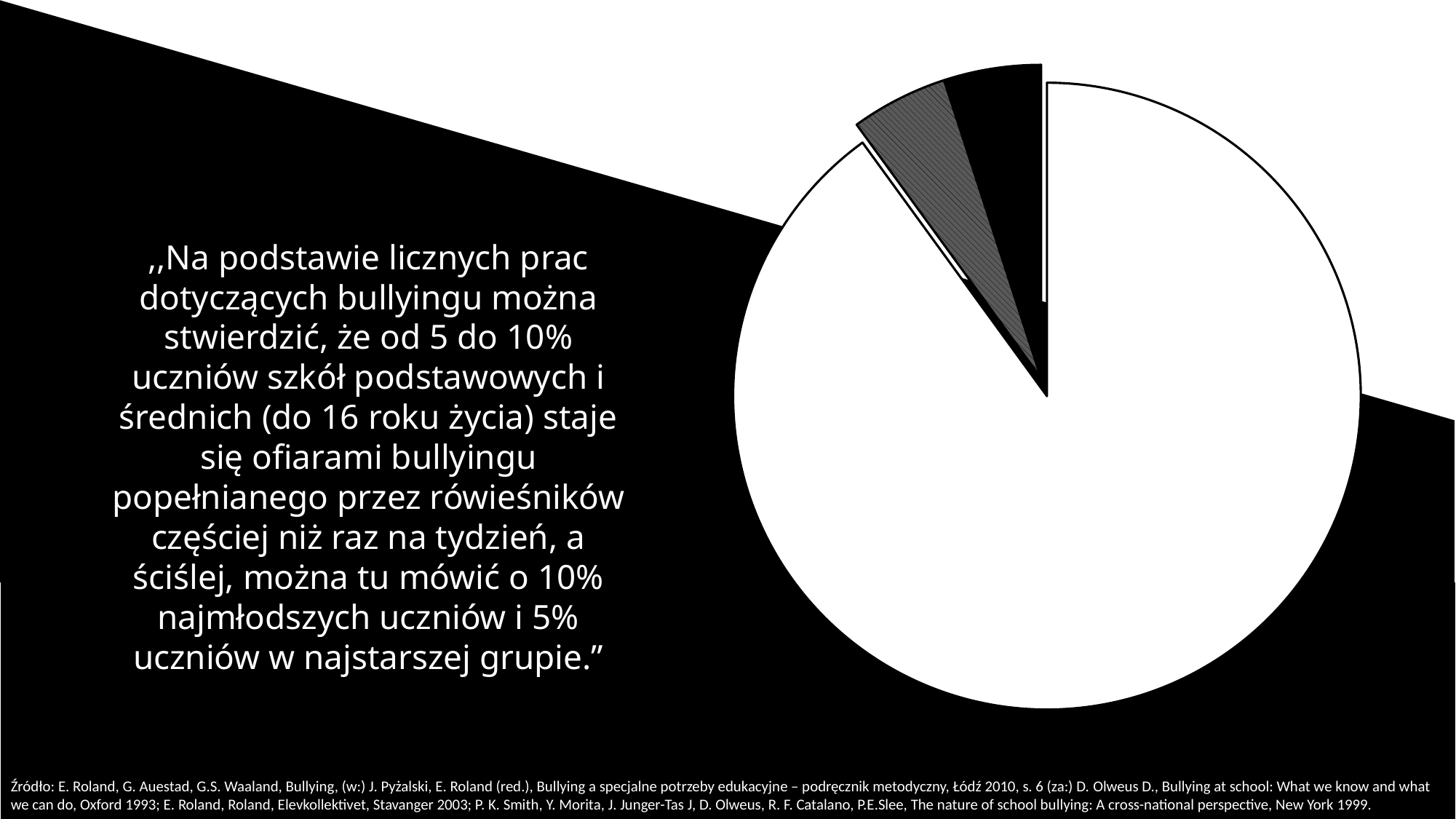
Does the pie chart display a legend? No Does the pie chart show any data labels with values? No How many slices does the pie chart have? 3 Which is larger in the pie chart, the white slice or the solid black slice? the white slice Which slice of the pie chart is the largest? the white slice What kind of chart is shown on the right side of the slide? pie chart Which is larger in the pie chart, the white slice or the hatched grey slice? the white slice